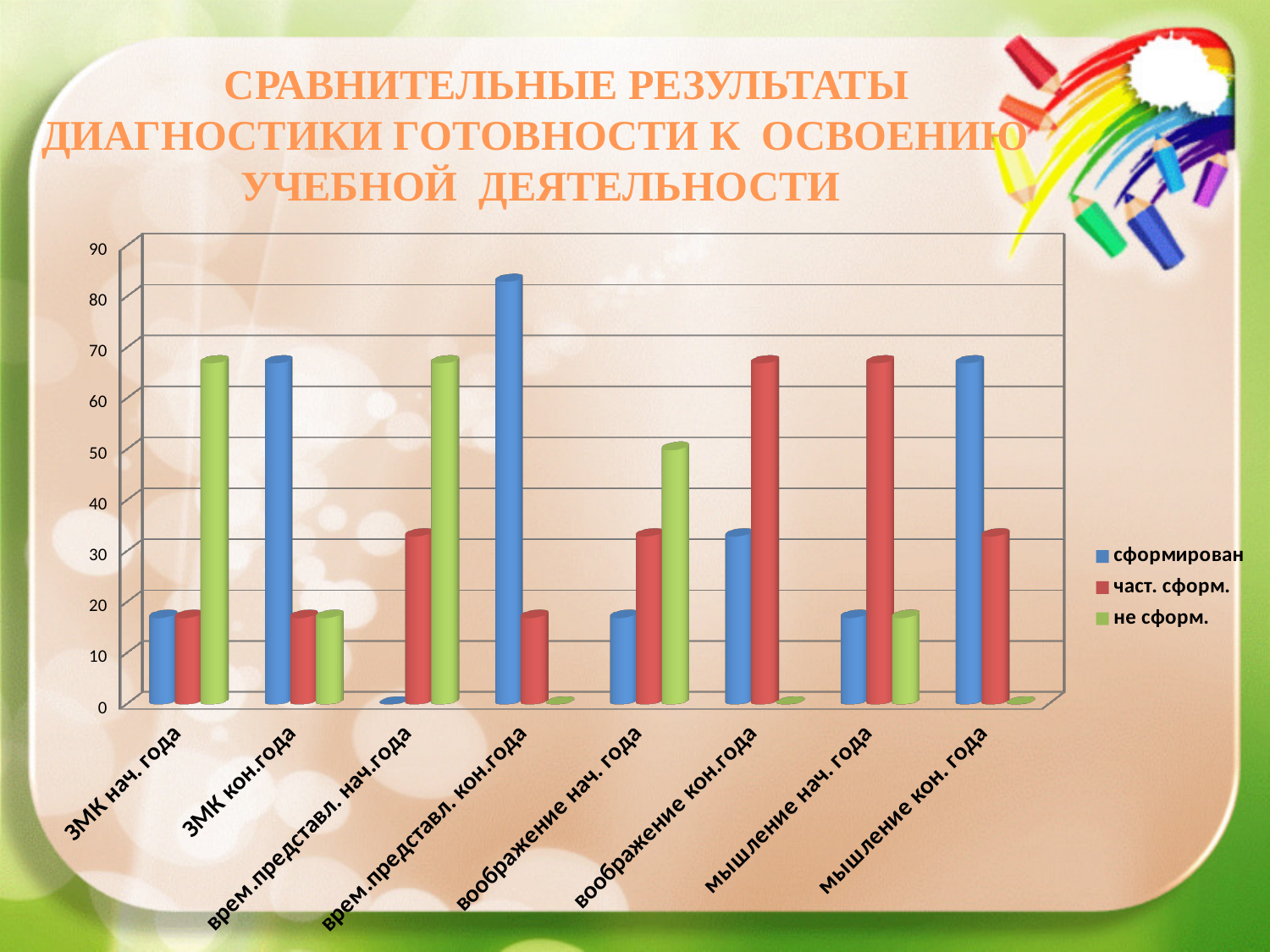
Is the value for 'сформирован' in 'ЗМК нач. года' greater or less than 20? less Is the value for 'не сформ.' in 'ЗМК нач. года' greater or less than 60? greater Which category has the highest value for the series 'сформирован'? врем.представл. кон.года Is the value for 'част. сформ.' in 'воображение кон.года' greater or less than 60? greater In 'мышление нач. года', which is larger: 'част. сформ.' or 'не сформ.'? част. сформ. Which colour represents the series 'не сформ.' in the legend? green Which category has the lowest value for the series 'сформирован'? врем.представл. нач.года In 'ЗМК кон.года', which is larger: 'сформирован' or 'част. сформ.'? сформирован How many series does the legend list? 3 What kind of chart is shown on the slide? bar chart How many categories are shown along the x axis? 8